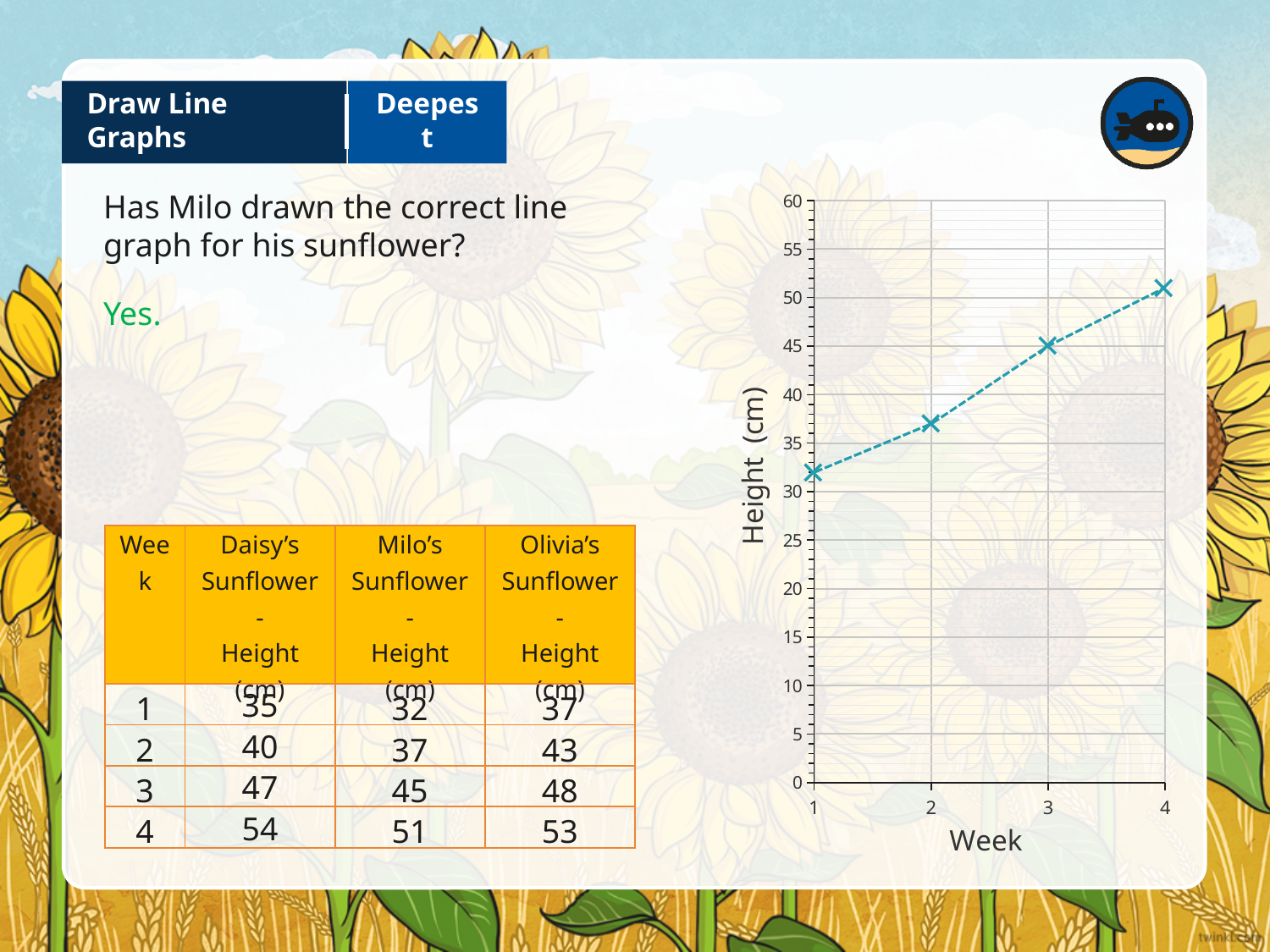
How many data points are plotted on the line graph? 4 What height is plotted for week 3 on the line graph? 45 Is the plotted value for week 2 greater or less than 40? less What is the label on the vertical axis of the line graph? Height (cm) What height is plotted for week 4 on the line graph? 51 Which week has the lowest plotted height on the line graph? Week 1 Which week has the highest plotted height on the line graph? Week 4 What kind of chart is shown on the slide? line chart What height is plotted for week 1 on the line graph? 32 Do the values on the line graph rise or fall as the weeks increase? rise Is the plotted value for week 4 greater or less than 50? greater What is the difference between the plotted heights for week 4 and week 1? 19